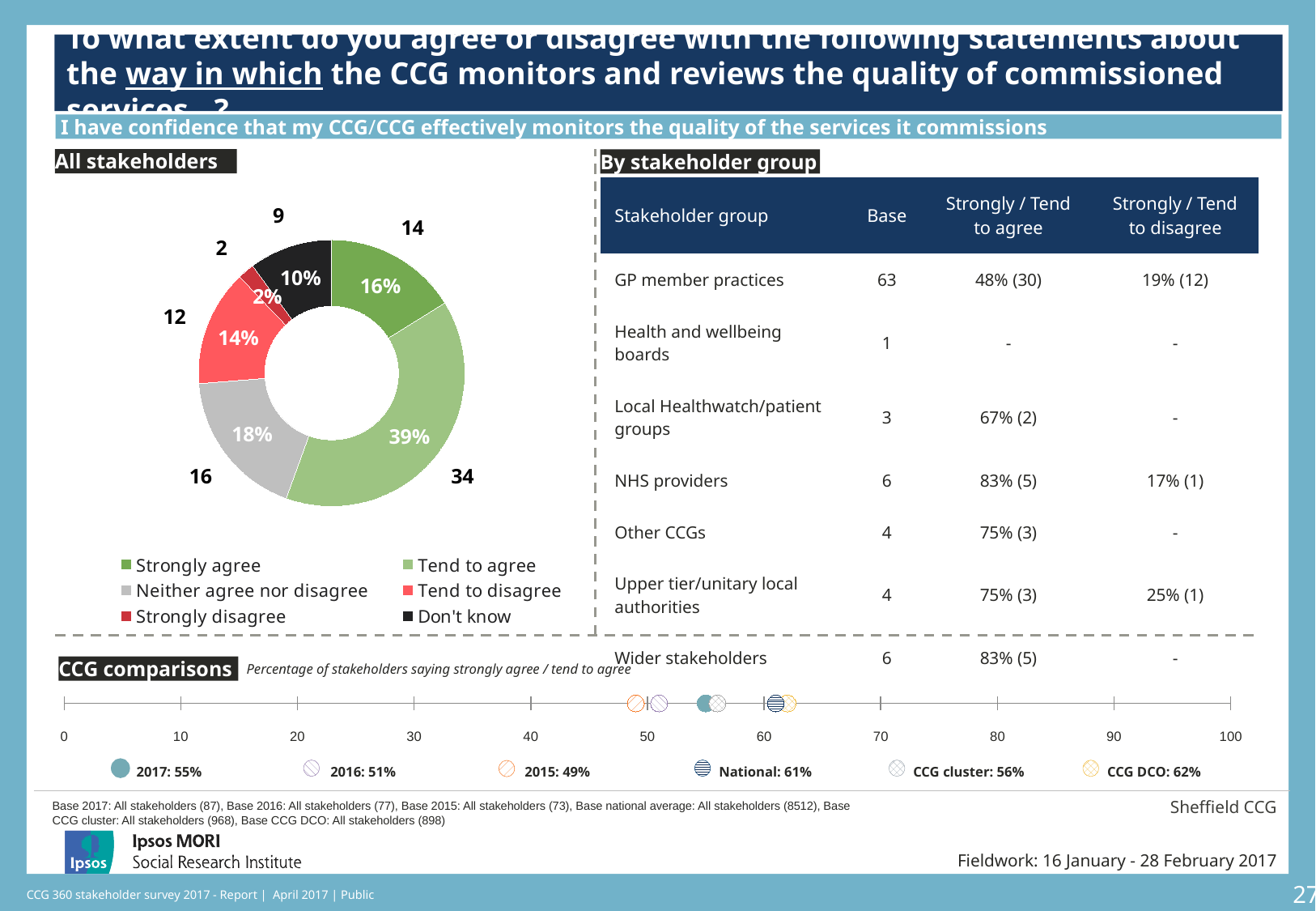
In the All stakeholders donut chart, which response category has the smallest share? Strongly disagree In the All stakeholders donut chart, what is the difference in percentage points between 'Tend to agree' and 'Strongly agree'? 23 percentage points In the CCG comparisons chart, which comparison point has the highest value? CCG DCO: 62% In the All stakeholders donut chart, how many stakeholders said 'Neither agree nor disagree'? 16 In the All stakeholders donut chart, what is the combined share of 'Strongly agree' and 'Tend to agree'? 55% In the All stakeholders donut chart, which is larger: 'Neither agree nor disagree' or 'Tend to disagree'? Neither agree nor disagree In the All stakeholders donut chart, which response category has the largest share? Tend to agree In the All stakeholders donut chart, what percentage of stakeholders said 'Don't know'? 10% In the CCG comparisons chart, what is the 2017 percentage of stakeholders saying strongly agree / tend to agree? 55% How many response categories does the legend of the All stakeholders chart list? 6 In the All stakeholders donut chart, what percentage of stakeholders said 'Tend to agree'? 39% What kind of chart is the All stakeholders chart? Donut (pie) chart